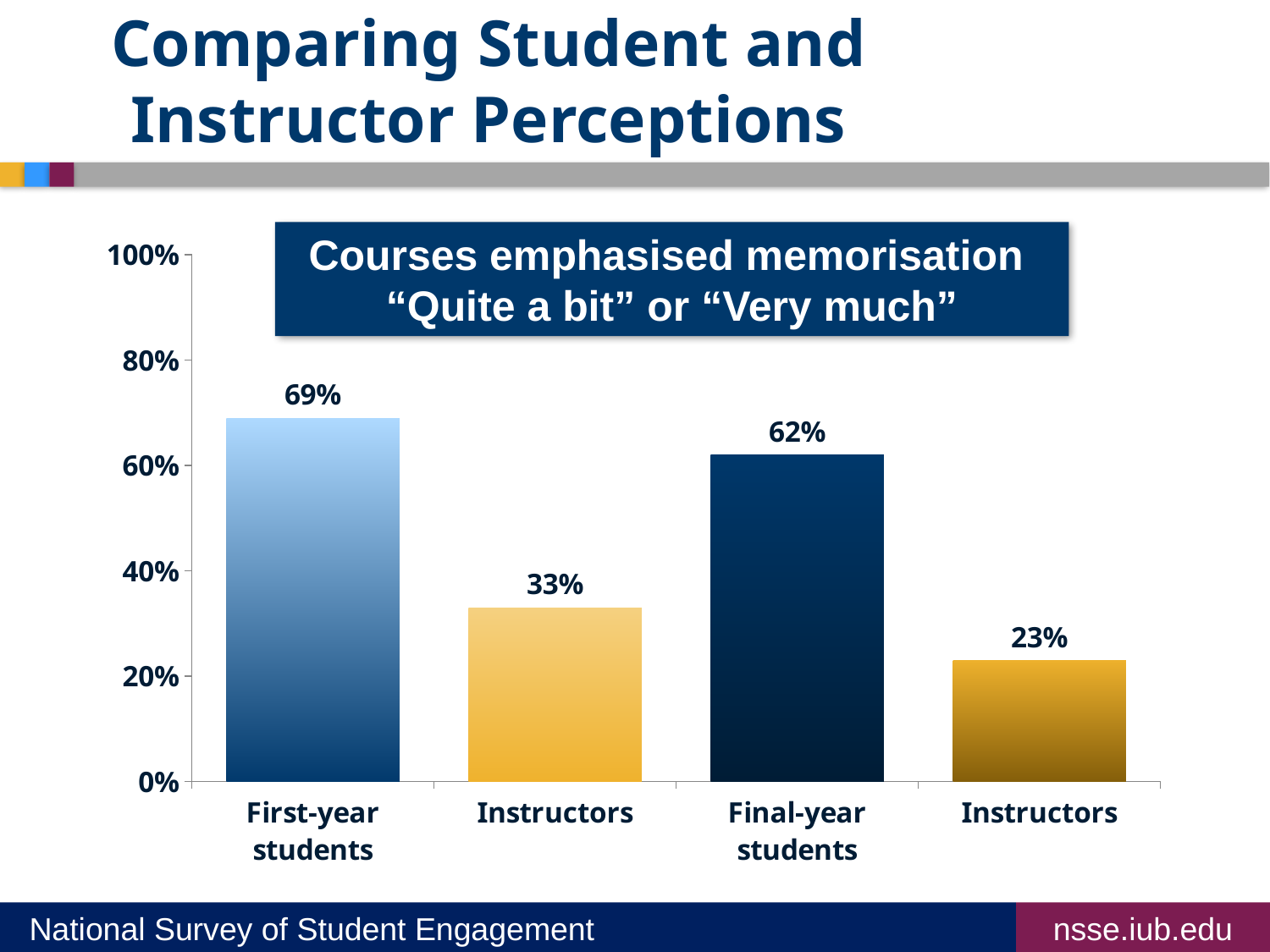
What kind of chart is shown? Bar chart How many bars are shown in the chart? 4 What is the title of the chart? Courses emphasised memorisation “Quite a bit” or “Very much” What is the value for Final-year students? 62% What is the value for First-year students? 69% What is the value for the Instructors bar next to First-year students? 33% Which is larger, First-year students or Final-year students? First-year students What is the difference between First-year students and the Instructors bar next to them? 36% Which category has the highest value? First-year students What is the value for the Instructors bar next to Final-year students? 23% What is the difference between Final-year students and the Instructors bar next to them? 39% Which category has the lowest value? Instructors (next to Final-year students)